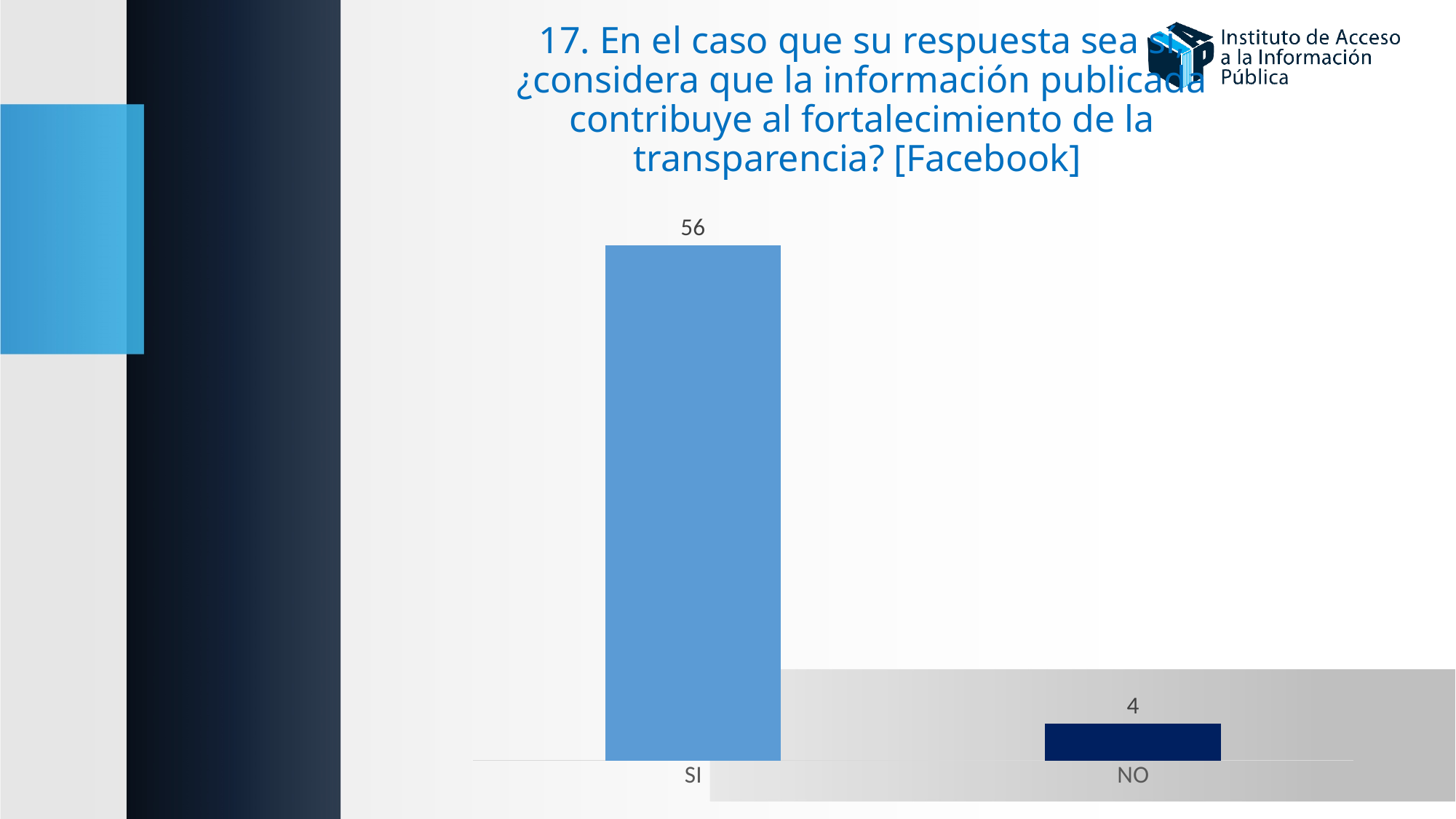
Which is larger, the value for SI or the value for NO? SI What is the value for NO? 4 What kind of chart is shown on the slide? Bar chart What is the value for SI? 56 What is the total of the values for SI and NO? 60 Which category has the highest value? SI Which social network is named in brackets in the chart title? Facebook What colour is the bar for NO? Dark blue What is the difference between the values for SI and NO? 52 How many categories are shown in the chart? 2 Which category has the lowest value? NO